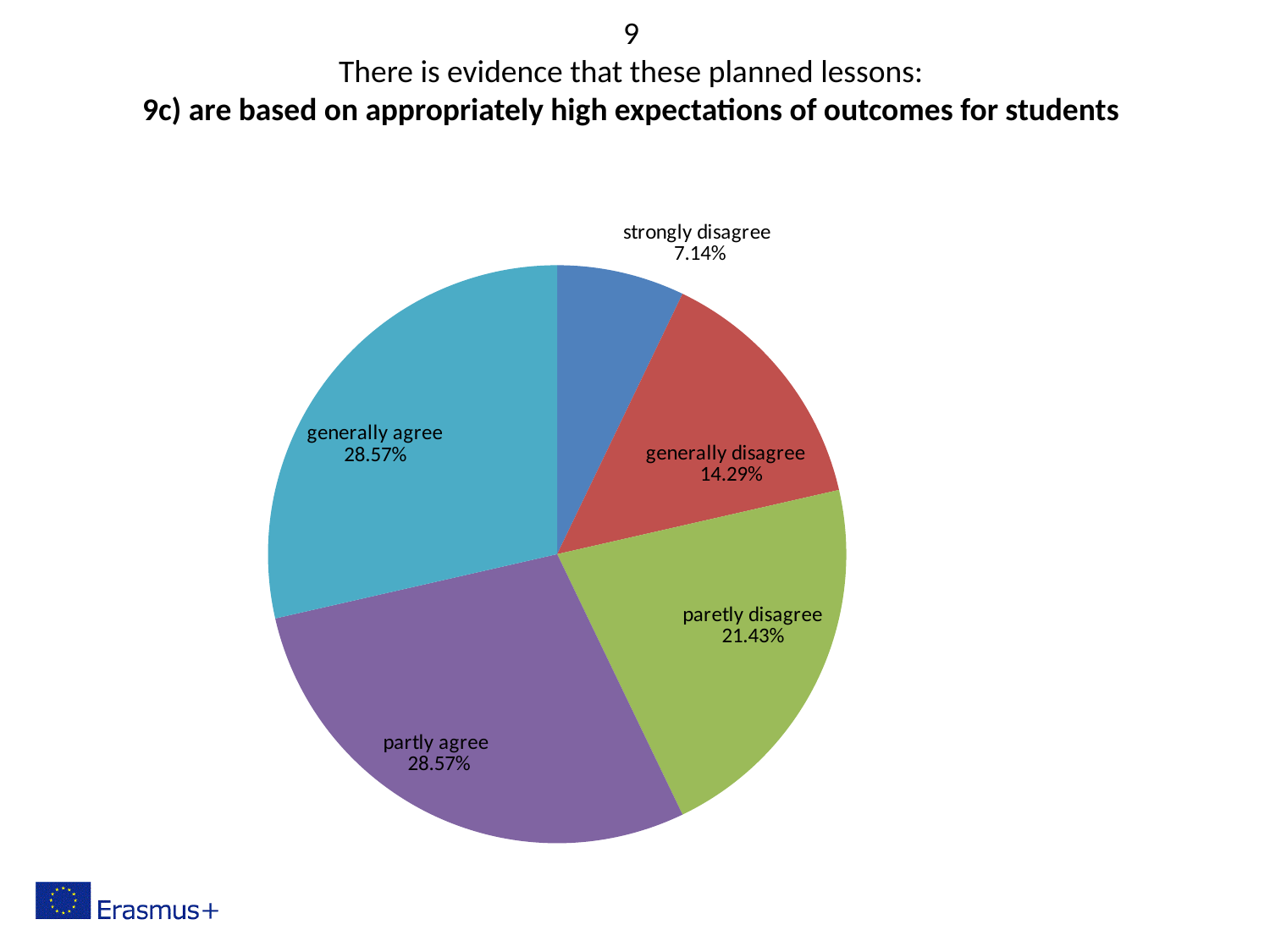
What is the difference between the "paretly disagree" share and the "strongly disagree" share? 14.29% What colour is the "partly agree" slice of the pie chart? purple What share of the pie is labelled "generally agree"? 28.57% Which is larger: the "generally disagree" slice or the "paretly disagree" slice? paretly disagree What share of the pie is labelled "strongly disagree"? 7.14% How many slices does the pie chart have? 5 What kind of chart is shown on the slide? pie chart What is the difference between the "partly agree" share and the "generally disagree" share? 14.28% What share of the pie is labelled "generally disagree"? 14.29% Which slice of the pie chart is the smallest? strongly disagree